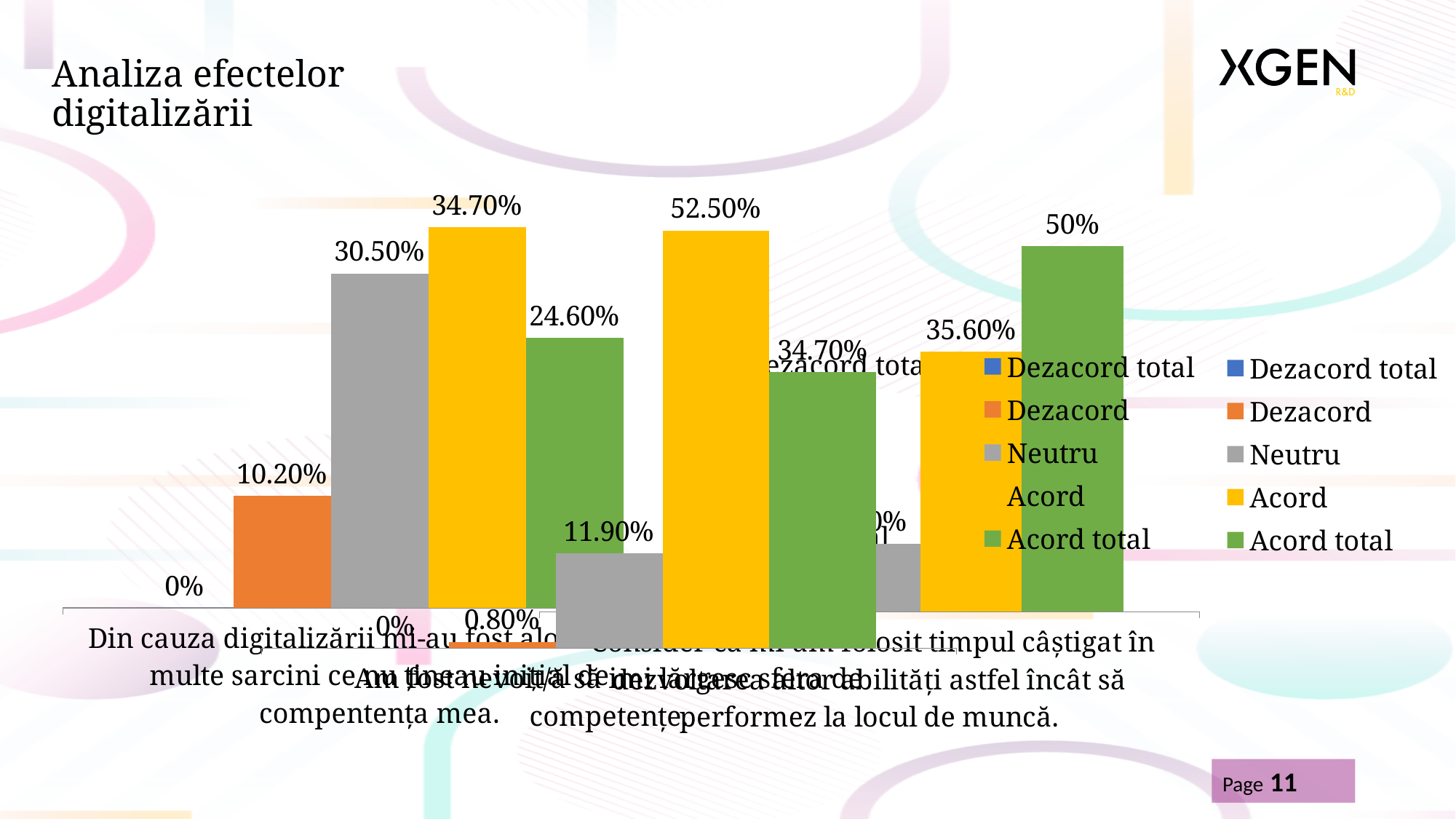
In the middle chart (the one about 'Am fost nevoit/ă să îmi dezvolt'), what is the value for Acord? 52.50% In the leftmost chart, what is the value for Acord total? 24.60% In the leftmost chart, which response category has the highest value? Acord How many series does the legend of each chart list? 5 In the middle chart, what is the value for Neutru? 11.90% In the rightmost chart (the one about 'Consider că nu am folosit timpul câștigat'), what is the value for Acord total? 50% In the leftmost chart (the one about 'Din cauza digitalizării mi-au fost alocate mai multe sarcini'), what is the value for Dezacord? 10.20% In the middle chart, which is larger, Acord or Acord total? Acord In the leftmost chart, what is the value for Neutru? 30.50% In the rightmost chart, what is the difference between the Acord total value and the Acord value? 14.40% In the leftmost chart, what is the difference between the Acord value and the Acord total value? 10.10% In the middle chart, what is the value for Dezacord? 0.80%